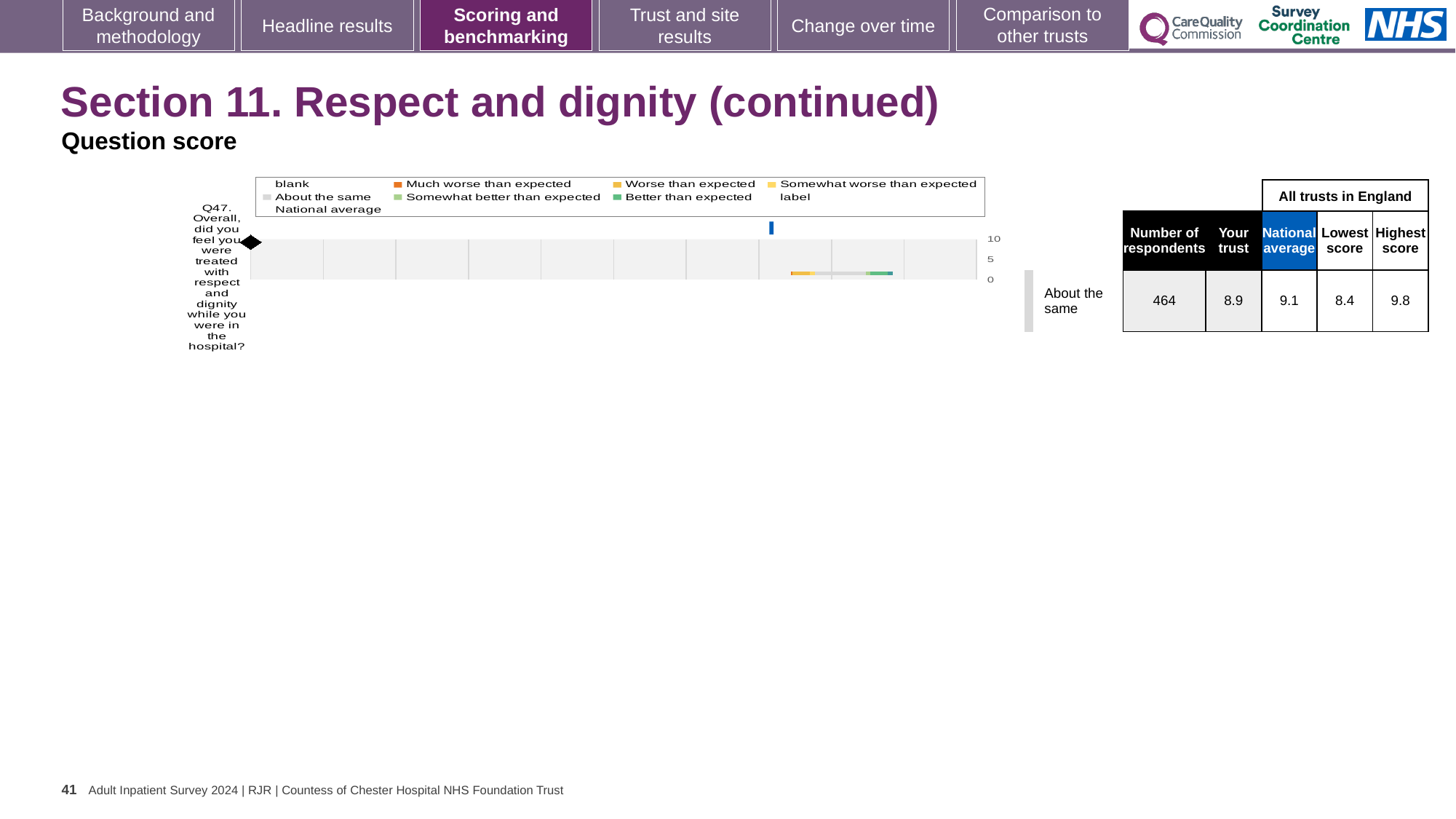
What is the difference between the highest and lowest scores for Q47 across all trusts in England? 1.4 What is the highest tick value shown on the chart's score axis? 10 Which question is plotted on the chart? Q47. Overall, did you feel you were treated with respect and dignity while you were in the hospital? What is the lowest score among all trusts in England for Q47? 8.4 What is the highest score among all trusts in England for Q47? 9.8 How many entries does the chart legend list? 9 What is the national average score for Q47 shown next to the chart? 9.1 How many respondents answered Q47? 464 What kind of chart is shown on the slide? bar chart How many question categories are plotted on the chart? 1 What is the 'Your trust' score for Q47 shown next to the chart? 8.9 Is the trust's score for Q47 larger or smaller than the national average? smaller